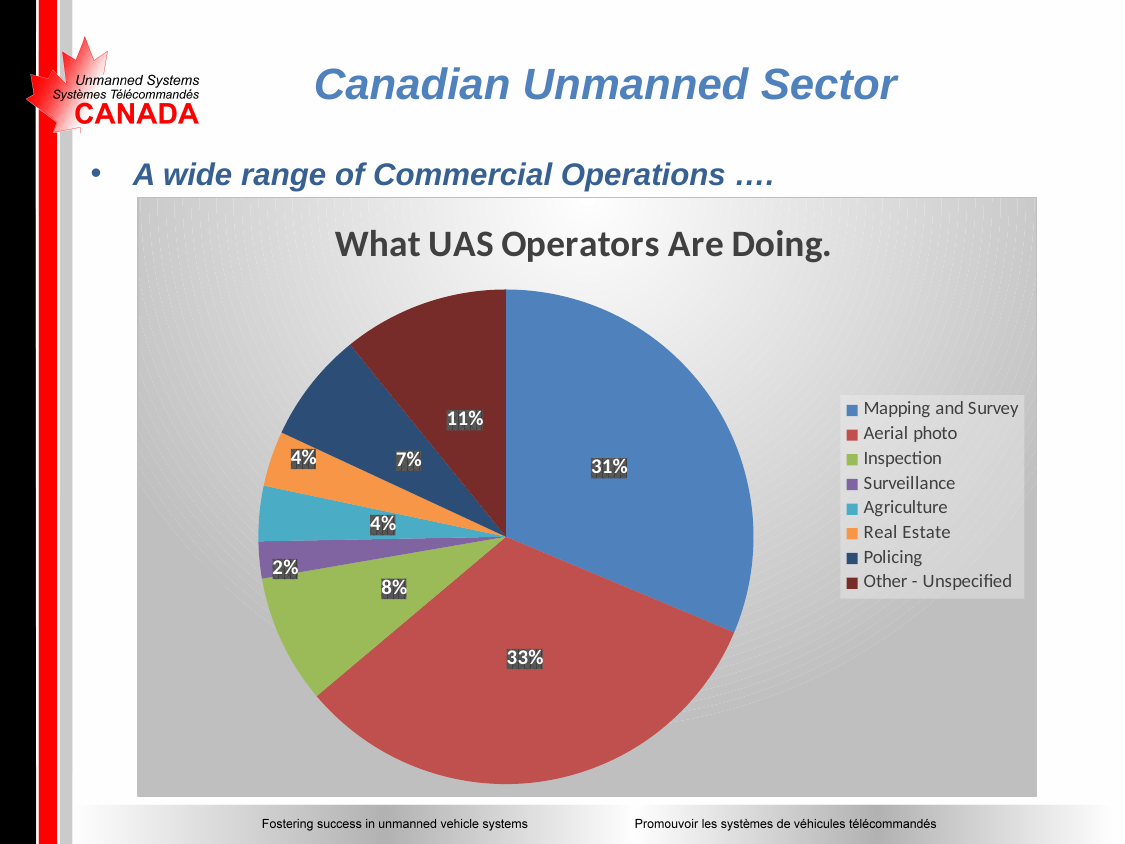
Which category has the smallest share of the pie? Surveillance What share of the pie is Mapping and Survey? 31% Which category has the largest share of the pie? Aerial photo Which is larger, the share for Inspection or the share for Policing? Inspection What kind of chart is shown on the slide? pie chart What share of the pie is Policing? 7% What share of the pie is Inspection? 8% What is the title of the chart? What UAS Operators Are Doing. How many categories does the legend list? 8 What is the difference in percentage points between Aerial photo and Mapping and Survey? 2